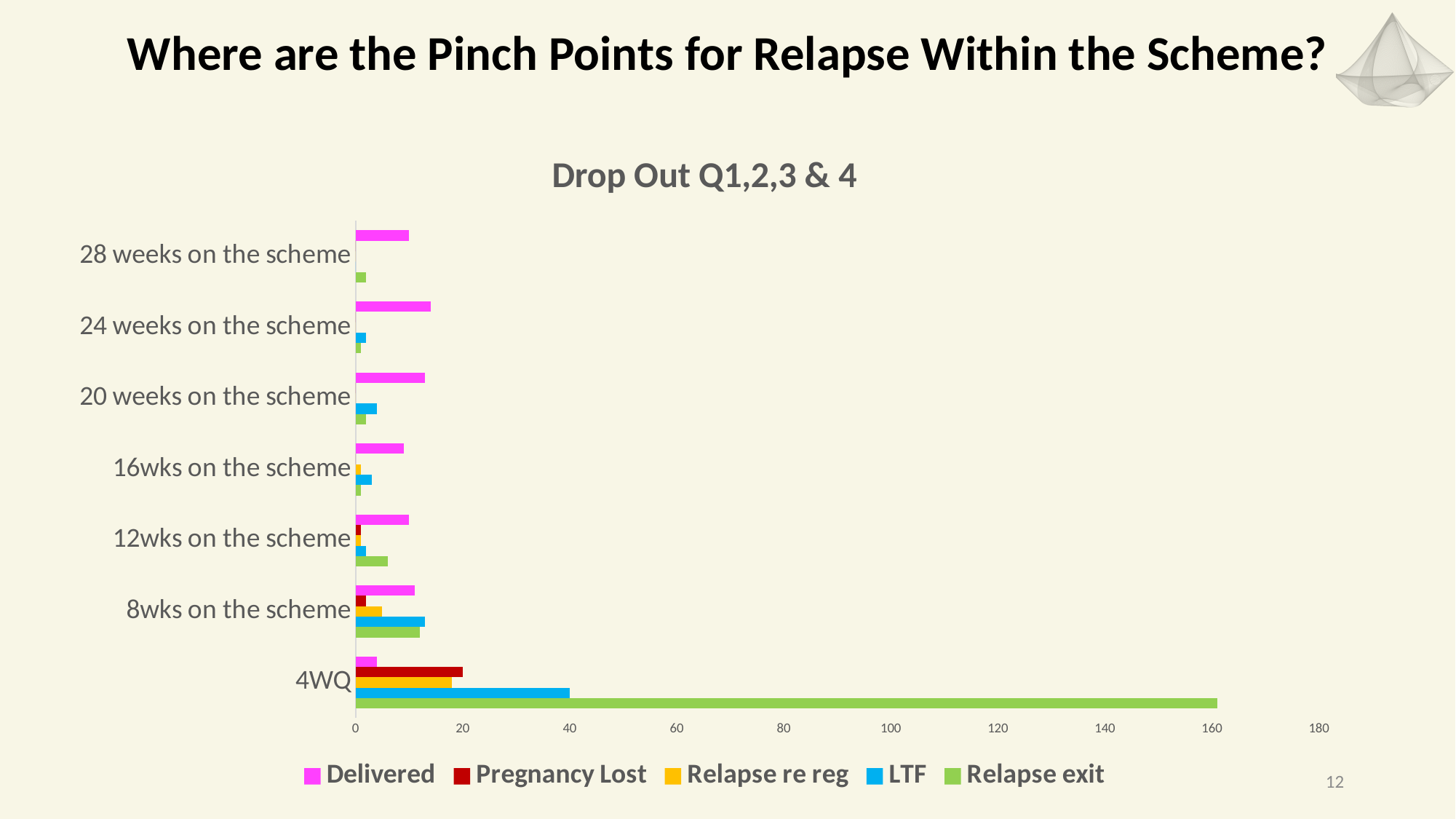
What kind of chart is shown on the slide? bar chart Which category has the highest Pregnancy Lost value? 4WQ How many series does the legend list? 5 How many categories are shown on the vertical axis? 7 Which is larger for 8wks on the scheme, the Delivered value or the Pregnancy Lost value? Delivered Which is larger for 4WQ, the LTF value or the Delivered value? LTF Is the Relapse exit value for 4WQ greater or less than 140? greater Is the Delivered value for 24 weeks on the scheme greater or less than 20? less What is the title of the chart? Drop Out Q1,2,3 & 4 Which series is shown in green in the legend? Relapse exit Which category has the highest Relapse exit value? 4WQ Is the LTF value for 4WQ greater or less than 20? greater